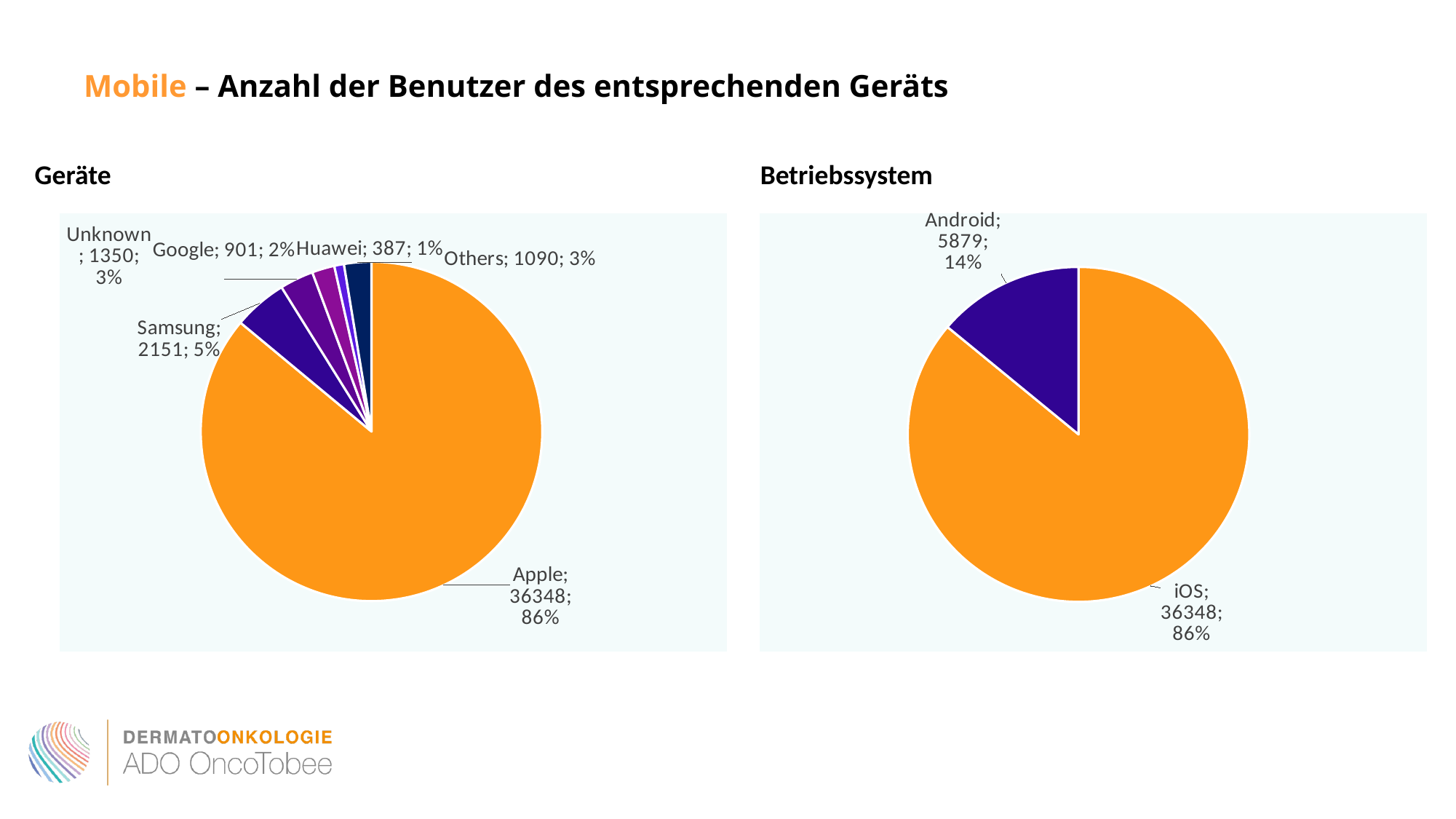
In the Betriebssystem chart, what share of the pie does iOS have? 86% In the Geräte chart, how many slices does the pie have? 6 In the Geräte chart, how many users does Apple have? 36348 What kind of chart is the Betriebssystem chart? Pie chart In the Geräte chart, which device has the smallest slice? Huawei In the Geräte chart, what is the difference in users between Samsung and Google? 1250 In the Betriebssystem chart, what is the difference in users between iOS and Android? 30469 In the Geräte chart, how many users does Samsung have? 2151 In the Geräte chart, what share of the pie does Huawei have? 1% In the Betriebssystem chart, how many users does Android have? 5879 In the Geräte chart, which device has the largest slice? Apple In the Geräte chart, which has more users, Unknown or Others? Unknown